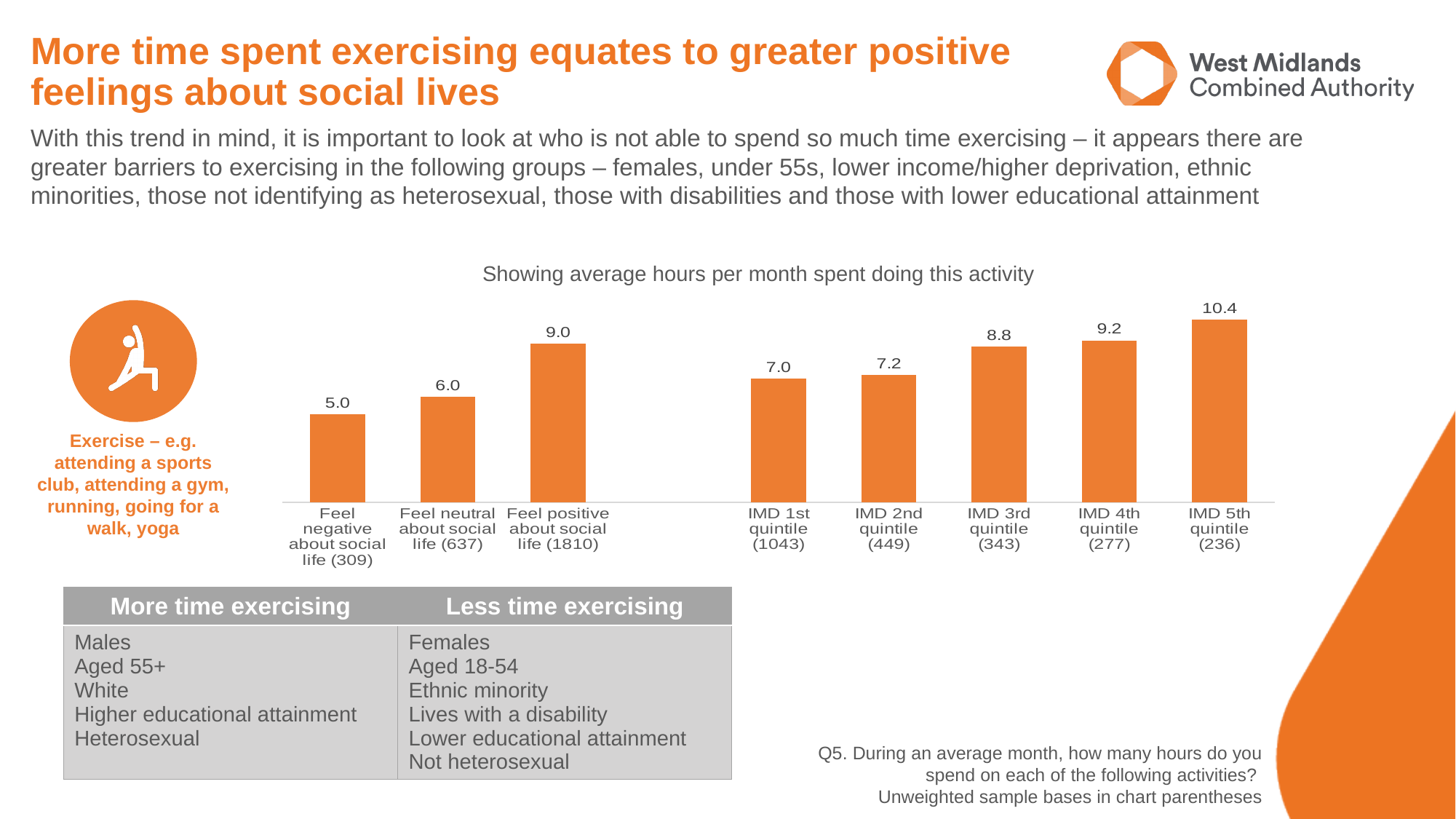
What kind of chart is shown on the slide? Bar chart What is the difference between the values for feeling positive and feeling negative about social life? 4.0 What is the average hours per month spent exercising for those who feel positive about social life? 9.0 What is the value shown for IMD 5th quintile? 10.4 Which category on the chart has the lowest value? Feel negative about social life What is the unweighted sample base shown for IMD 1st quintile? 1043 What is the difference between the values for IMD 5th quintile and IMD 1st quintile? 3.4 Which is larger, the value for IMD 3rd quintile or the value for IMD 4th quintile? IMD 4th quintile How many IMD quintile bars are shown on the chart? 5 Which IMD quintile has the highest average hours per month spent exercising? IMD 5th quintile What is the value shown for those who feel neutral about social life? 6.0 Do the values rise or fall from IMD 1st quintile to IMD 5th quintile? Rise